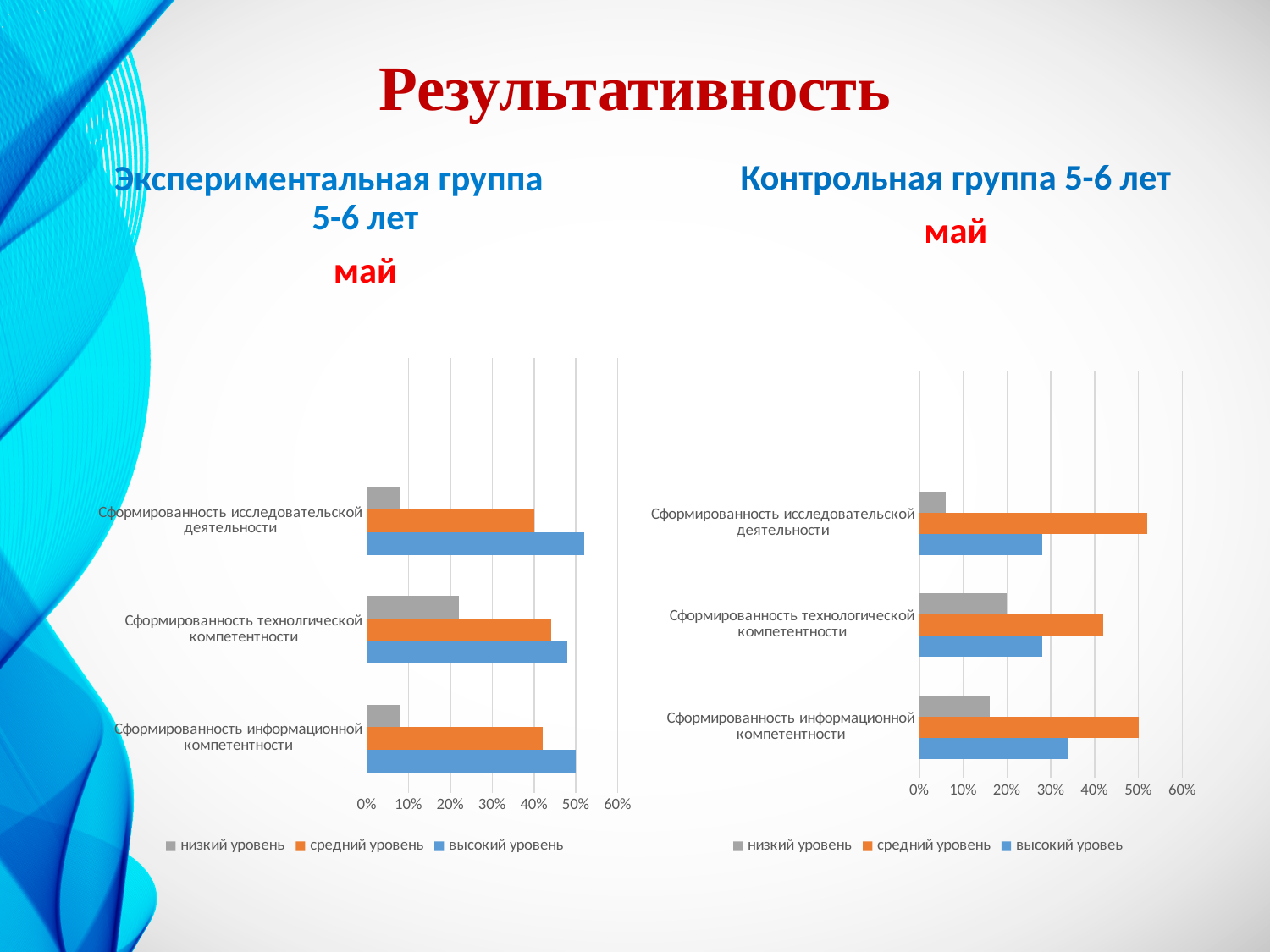
In the left chart (Экспериментальная группа 5-6 лет), which is larger for Сформированность исследовательской деятельности: средний уровень or высокий уровень? высокий уровень In the right chart (Контрольная группа 5-6 лет), which series has the highest value for Сформированность информационной компетентности? средний уровень In the right chart (Контрольная группа 5-6 лет), is the value of средний уровень for Сформированность исследовательской деятельности greater or less than 50%? greater How many categories are shown on the left chart (Экспериментальная группа 5-6 лет)? 3 What colour represents средний уровень in the left chart's legend? orange In the left chart (Экспериментальная группа 5-6 лет), is the value of низкий уровень for Сформированность технологической компетентности greater or less than 30%? less In the left chart (Экспериментальная группа 5-6 лет), which series has the lowest value for Сформированность информационной компетентности? низкий уровень How many series does the legend of the right chart (Контрольная группа 5-6 лет) list? 3 What kind of chart is the left chart (Экспериментальная группа 5-6 лет)? bar chart In the right chart (Контрольная группа 5-6 лет), which category has the highest value of низкий уровень? Сформированность технологической компетентности In the right chart (Контрольная группа 5-6 лет), is the value of высокий уровень for Сформированность технологической компетентности greater or less than 30%? less